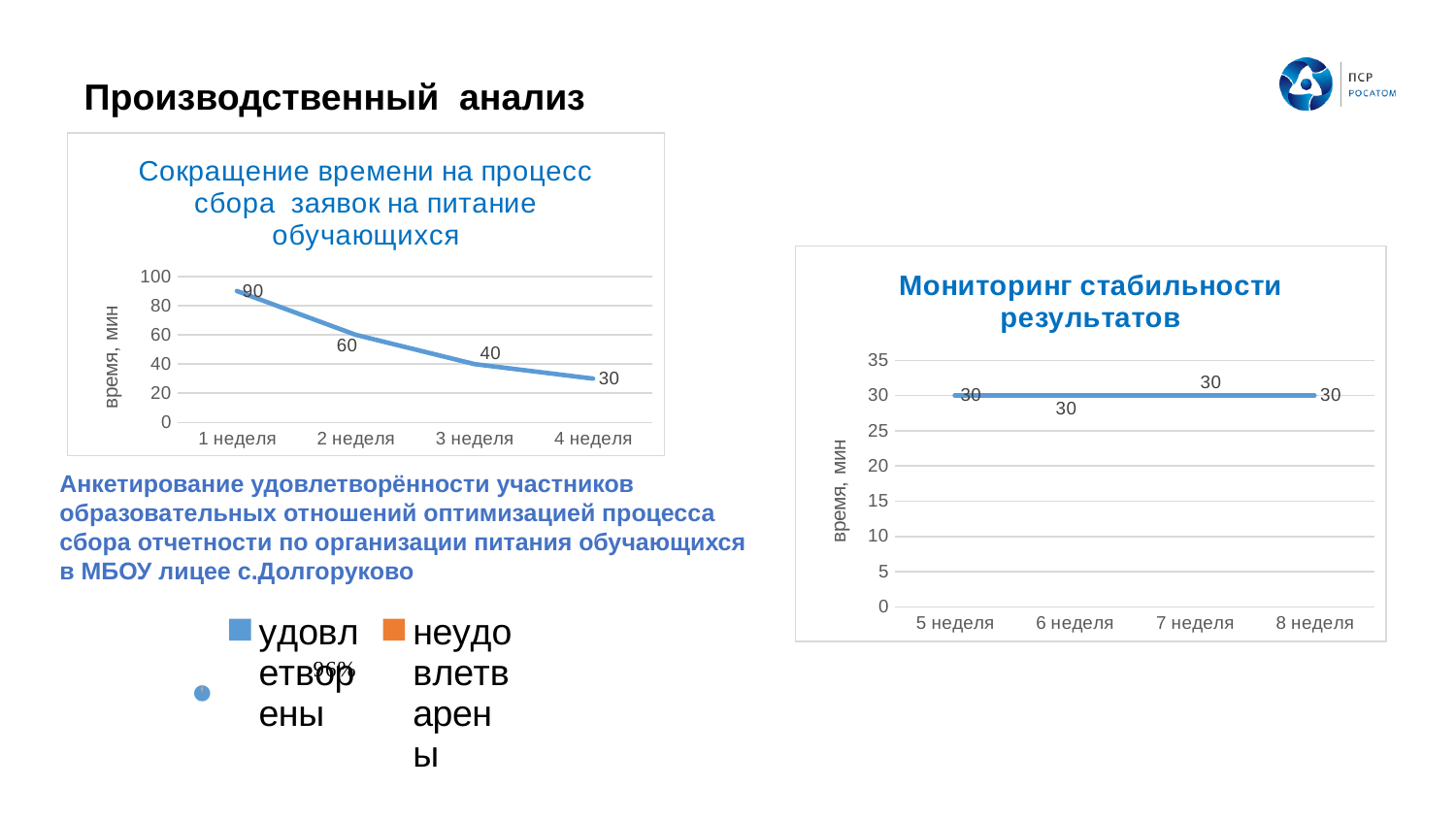
In the chart 'Сокращение времени на процесс сбора заявок на питание обучающихся', do the values rise or fall from 1 неделя to 4 неделя? fall In the chart 'Мониторинг стабильности результатов', do the values rise, fall or stay flat from 5 неделя to 8 неделя? stay flat In the chart 'Сокращение времени на процесс сбора заявок на питание обучающихся', what is the value for 3 неделя? 40 What kind of chart is 'Сокращение времени на процесс сбора заявок на питание обучающихся'? line chart In the chart 'Сокращение времени на процесс сбора заявок на питание обучающихся', which week has the highest value? 1 неделя In the chart 'Сокращение времени на процесс сбора заявок на питание обучающихся', what is the difference between the values for 1 неделя and 4 неделя? 60 In the chart 'Сокращение времени на процесс сбора заявок на питание обучающихся', which week has the lowest value? 4 неделя What is the y-axis label of the chart 'Мониторинг стабильности результатов'? время, мин How many weeks are plotted in the chart 'Мониторинг стабильности результатов'? 4 In the chart 'Сокращение времени на процесс сбора заявок на питание обучающихся', what is the value for 1 неделя? 90 In the chart 'Сокращение времени на процесс сбора заявок на питание обучающихся', which is larger: the value for 2 неделя or 3 неделя? 2 неделя In the chart 'Мониторинг стабильности результатов', what is the value for 7 неделя? 30